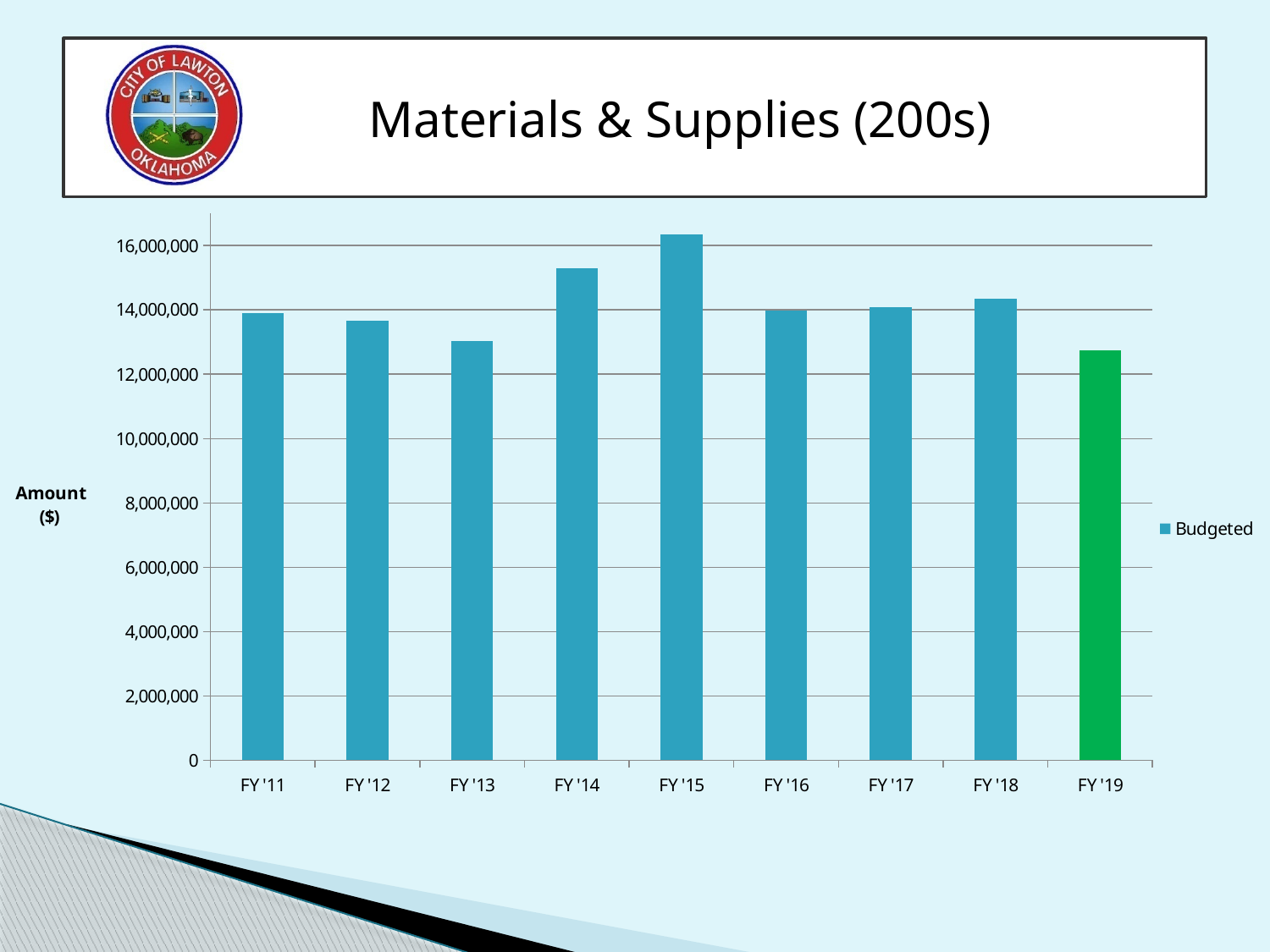
What is the title of the chart on the slide? Materials & Supplies (200s) Which fiscal year has the lowest budgeted amount? FY '19 How many fiscal years are plotted on the x axis? 9 Is the value for FY '15 greater or less than 16,000,000? greater Do the values rise or fall from FY '13 to FY '15? rise Which is larger, the value for FY '14 or the value for FY '15? FY '15 Is the value for FY '14 greater or less than 14,000,000? greater What kind of chart is shown on the slide? bar chart How many series does the legend list? 1 Which fiscal year has the highest budgeted amount? FY '15 Is the value for FY '19 greater or less than 14,000,000? less